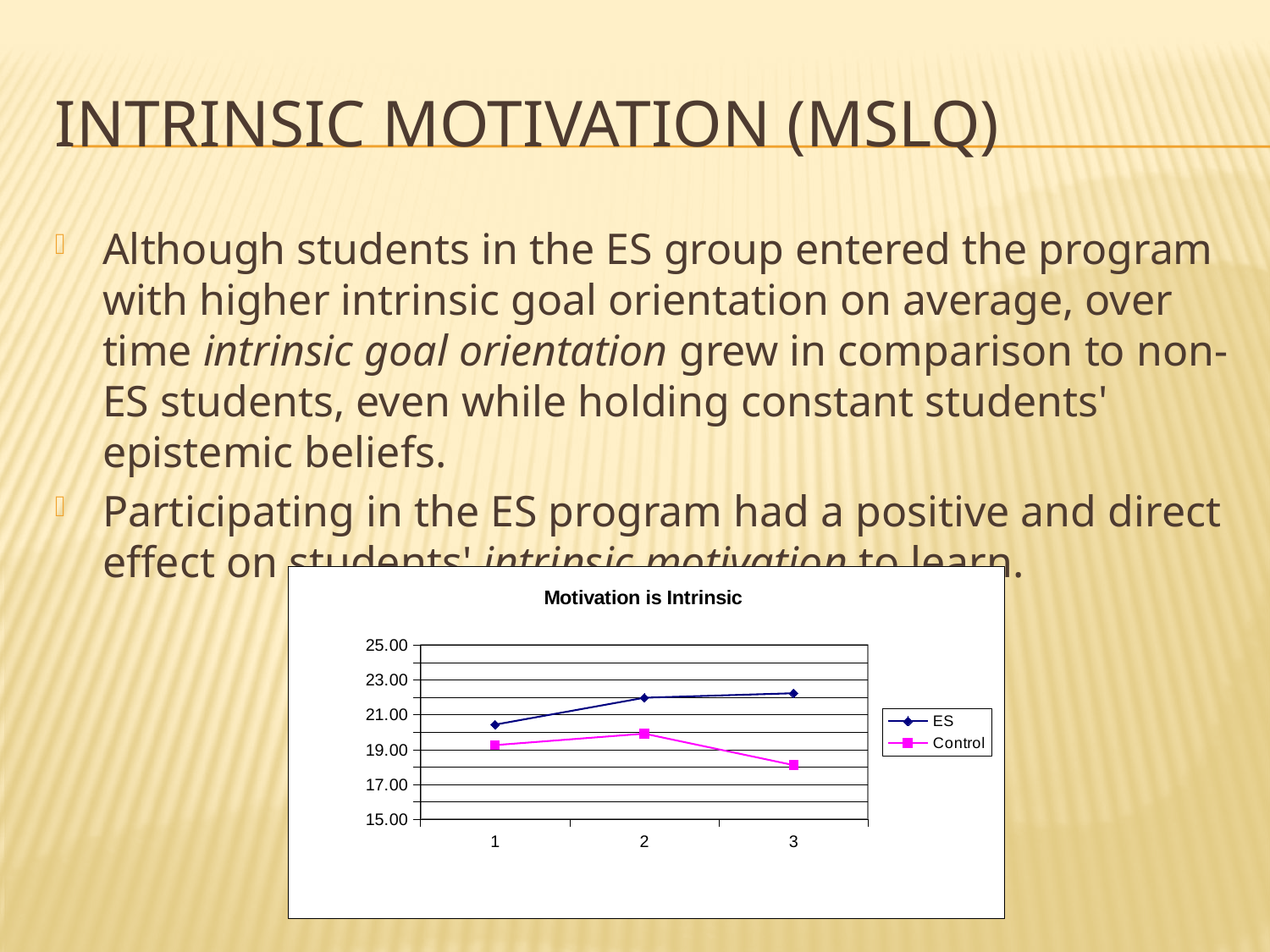
Is the value for Control at x = 3 greater or less than 19.00? less Is the value for ES at x = 3 greater or less than 21.00? greater At x = 3, which series has the higher value, ES or Control? ES How many points are plotted along the x axis for each series? 3 At which x value does the Control series reach its lowest point? 3 Does the ES series rise or fall from x = 1 to x = 3? rise How many series does the chart's legend list? 2 What kind of chart is shown on the slide? line chart Is the value for Control at x = 2 greater or less than 21.00? less What is the title of the chart? Motivation is Intrinsic Which series is drawn in magenta (pink) with square markers? Control At which x value does the Control series reach its highest point? 2